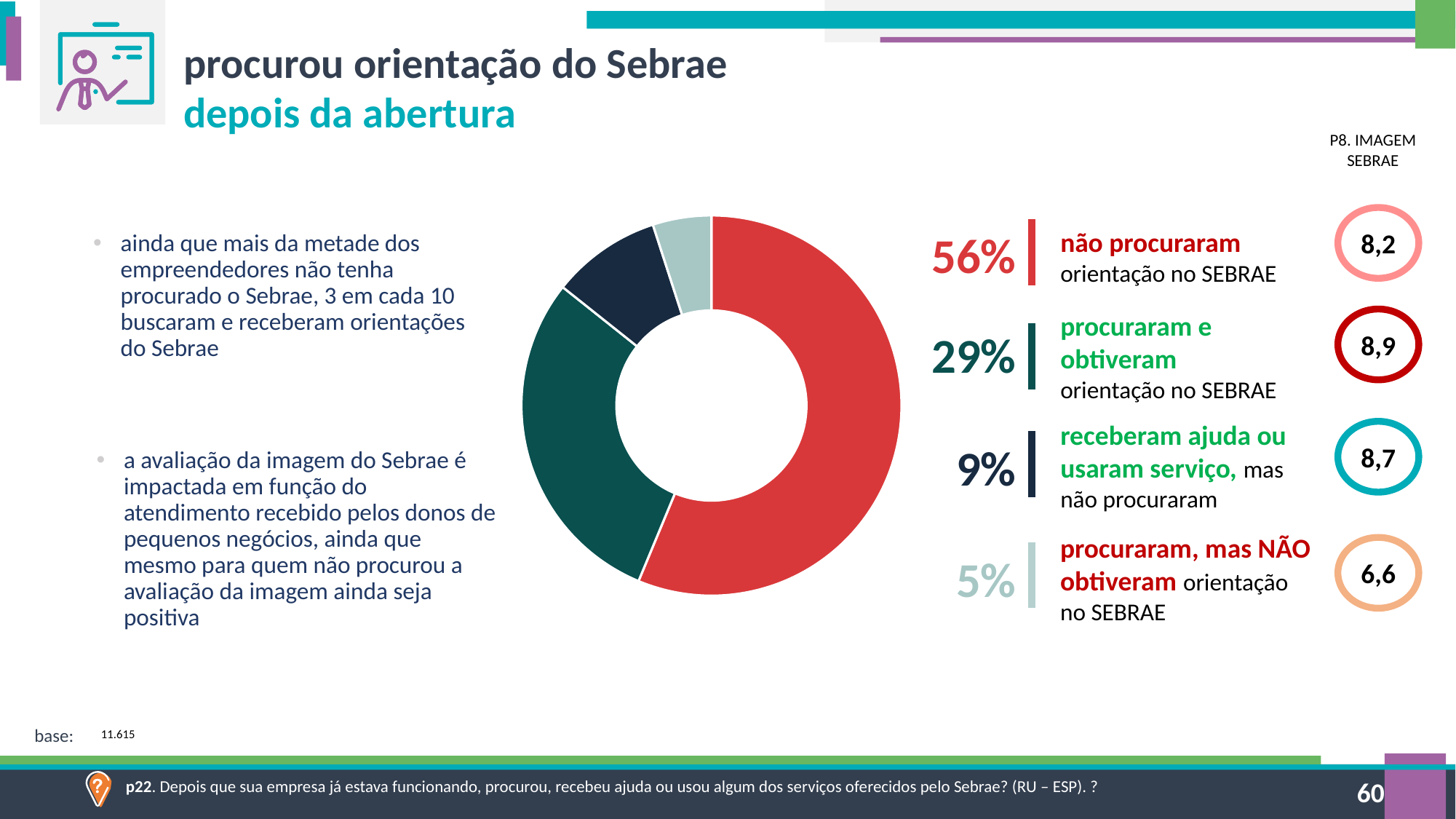
Which category has the largest slice of the donut chart? não procuraram orientação no SEBRAE What is the base (number of respondents) shown for the chart? 11.615 What share of respondents received help or used a service but did not seek it ("receberam ajuda ou usaram serviço, mas não procuraram")? 9% What colour is the slice representing "não procuraram orientação no SEBRAE"? Red Which category has the smallest slice of the donut chart? procuraram, mas NÃO obtiveram orientação no SEBRAE What share of respondents sought but did NOT obtain guidance from SEBRAE ("procuraram, mas NÃO obtiveram orientação no SEBRAE")? 5% What kind of chart is shown on the slide? Pie chart (donut) Which is larger: the share for "receberam ajuda ou usaram serviço, mas não procuraram" or the share for "procuraram, mas NÃO obtiveram"? receberam ajuda ou usaram serviço, mas não procuraram What share of respondents sought and obtained guidance from SEBRAE ("procuraram e obtiveram orientação no SEBRAE")? 29% What share of respondents did not seek guidance from SEBRAE ("não procuraram orientação no SEBRAE")? 56% How many categories are shown in the donut chart? 4 What is the difference in percentage points between "não procuraram" and "procuraram e obtiveram"? 27 percentage points